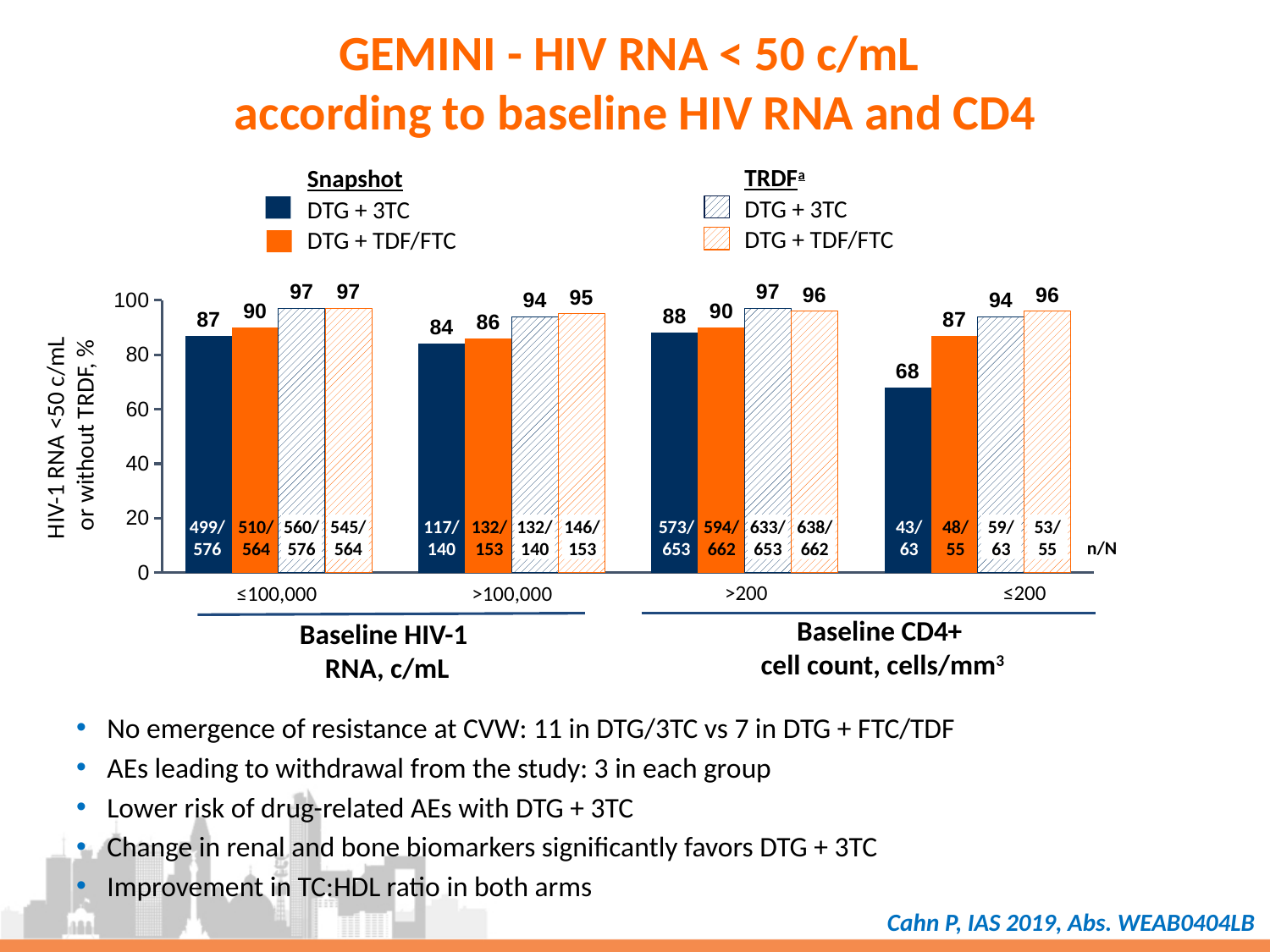
What is the TRDF value for DTG + 3TC in the >200 baseline CD4+ cell count group? 97 In the >100,000 baseline HIV-1 RNA group, which is larger: the Snapshot value for DTG + 3TC or for DTG + TDF/FTC? DTG + TDF/FTC What kind of chart is shown on the slide? bar chart Which group has the lowest Snapshot value for DTG + 3TC? ≤200 What is the Snapshot value for DTG + 3TC in the ≤100,000 baseline HIV-1 RNA group? 87 Is the Snapshot value for DTG + 3TC in the ≤200 baseline CD4+ group greater or less than 80? less What is the n/N shown for Snapshot DTG + 3TC in the ≤200 baseline CD4+ group? 43/63 How many series does the legend list in total? 4 How many baseline subgroups are shown on the x axis? 4 What is the difference between the Snapshot values for DTG + TDF/FTC and DTG + 3TC in the ≤200 baseline CD4+ group? 19 What is the y-axis label of the chart? HIV-1 RNA <50 c/mL or without TRDF, % What is the Snapshot value for DTG + TDF/FTC in the ≤200 baseline CD4+ cell count group? 87